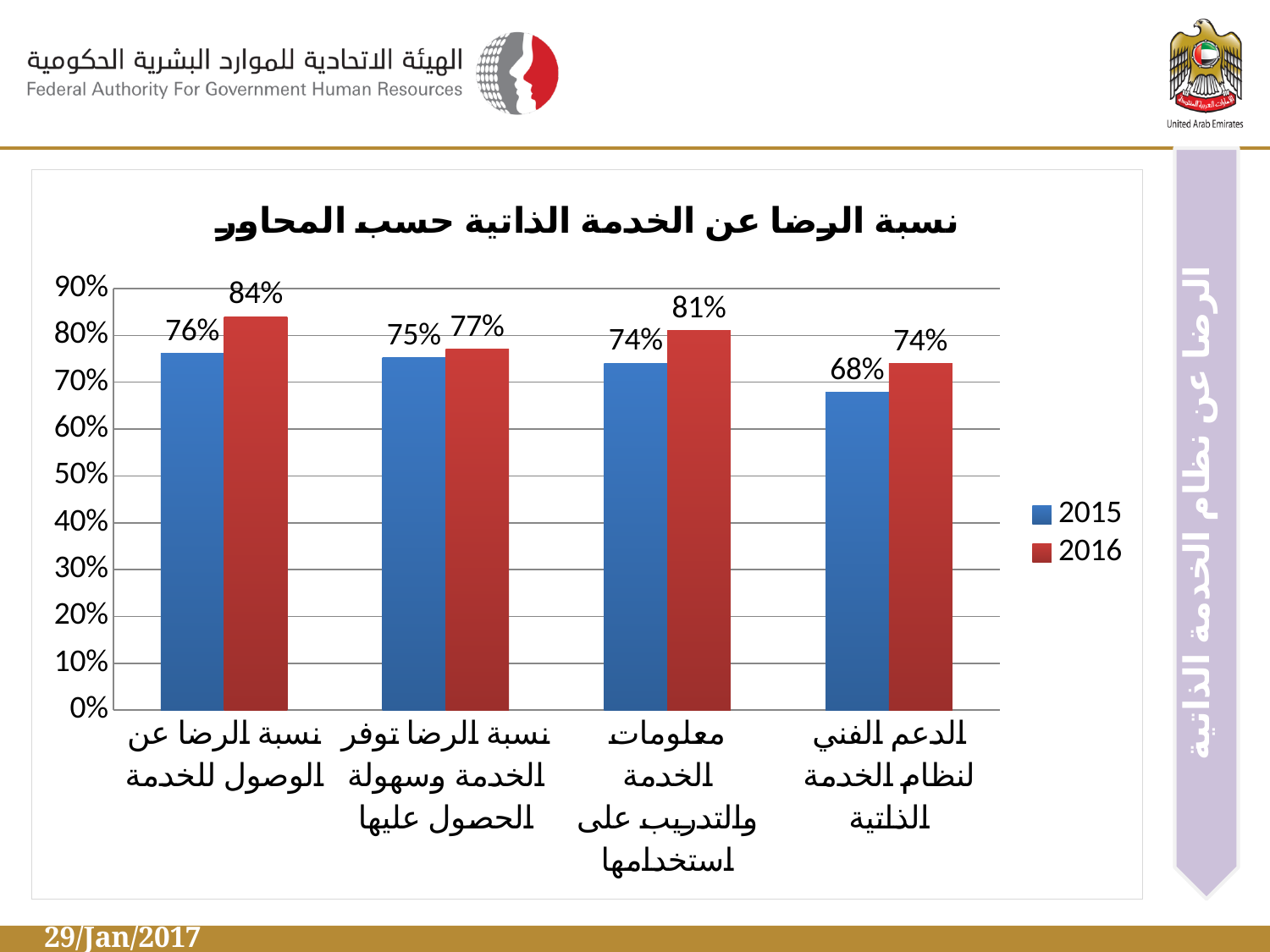
Which category has the highest 2016 value? نسبة الرضا عن الوصول للخدمة What is the 2016 value for "نسبة الرضا عن الوصول للخدمة"? 84% Is the 2015 value for "الدعم الفني لنظام الخدمة الذاتية" greater or less than 70%? less How many categories are shown on the x axis? 4 Which category has the lowest 2015 value? الدعم الفني لنظام الخدمة الذاتية How many series does the legend list? 2 Which colour represents the 2016 series in the legend? Red What type of chart is shown on the slide? Bar chart What is the 2015 value for "الدعم الفني لنظام الخدمة الذاتية"? 68% What is the difference between the 2016 and 2015 values for "معلومات الخدمة والتدريب على استخدامها"? 7% Which is larger for "نسبة الرضا توفر الخدمة وسهولة الحصول عليها": the 2015 value or the 2016 value? 2016 What is the 2016 value for "معلومات الخدمة والتدريب على استخدامها"? 81%